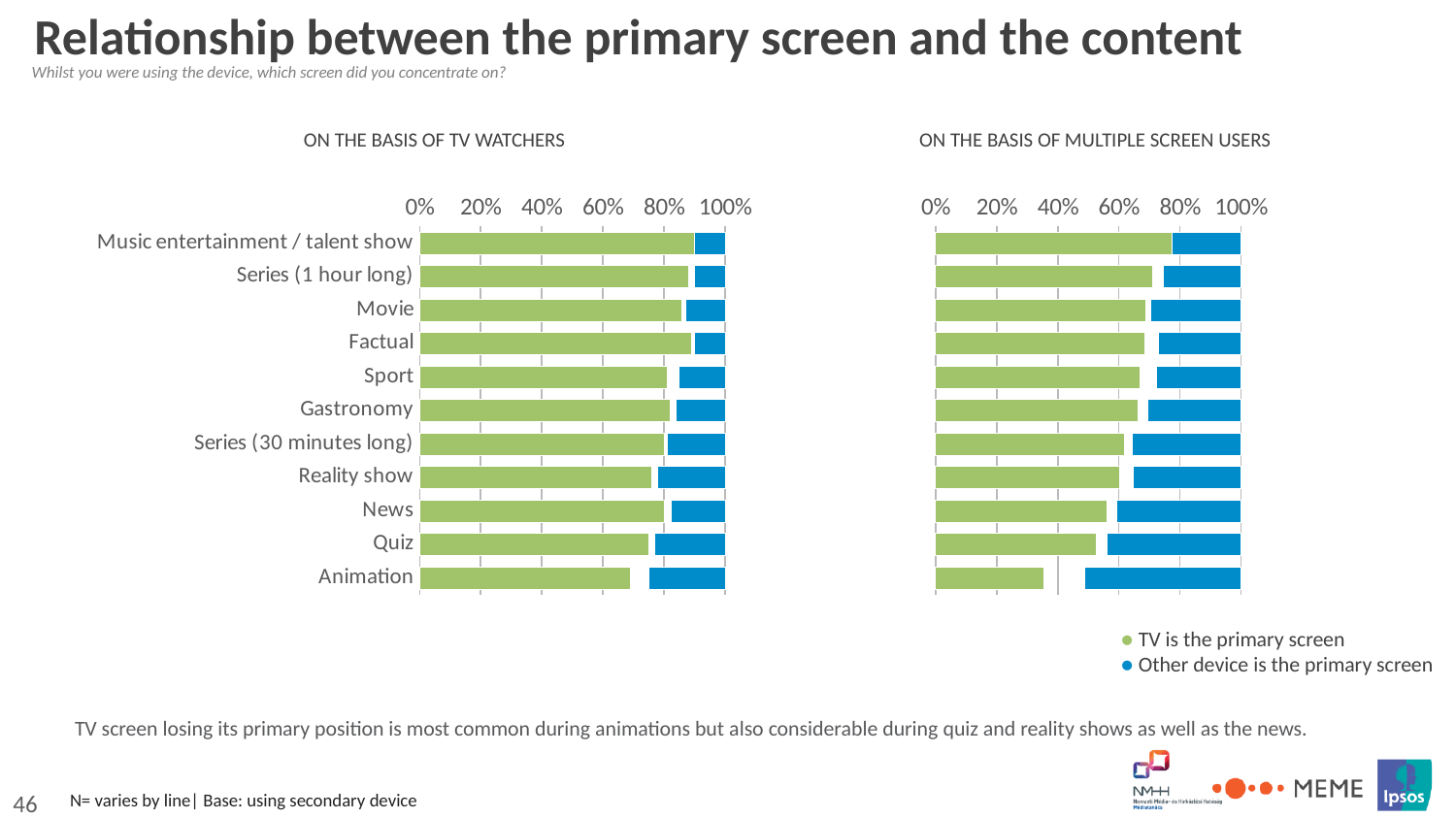
In the left chart, 'ON THE BASIS OF TV WATCHERS', is the 'TV is the primary screen' value for Animation greater or less than 80%? less In the right chart, 'ON THE BASIS OF MULTIPLE SCREEN USERS', which category has the lowest share for 'TV is the primary screen'? Animation Which colour represents 'TV is the primary screen' in the legend? green What kind of chart is used on the left, titled 'ON THE BASIS OF TV WATCHERS'? bar chart In the right chart, 'ON THE BASIS OF MULTIPLE SCREEN USERS', which category has the highest share for 'TV is the primary screen'? Music entertainment / talent show In the right chart, 'ON THE BASIS OF MULTIPLE SCREEN USERS', is the 'TV is the primary screen' value for Animation greater or less than 40%? less In the left chart, 'ON THE BASIS OF TV WATCHERS', do the 'TV is the primary screen' bars generally get longer or shorter going from the top category to the bottom? shorter In the left chart, 'ON THE BASIS OF TV WATCHERS', is the 'TV is the primary screen' value for Music entertainment / talent show greater or less than 80%? greater In the left chart, 'ON THE BASIS OF TV WATCHERS', which category has the lowest share for 'TV is the primary screen'? Animation How many content categories are listed on the left chart, 'ON THE BASIS OF TV WATCHERS'? 11 In the right chart, 'ON THE BASIS OF MULTIPLE SCREEN USERS', which has the larger 'TV is the primary screen' share: Sport or Animation? Sport How many series does the legend list? 2